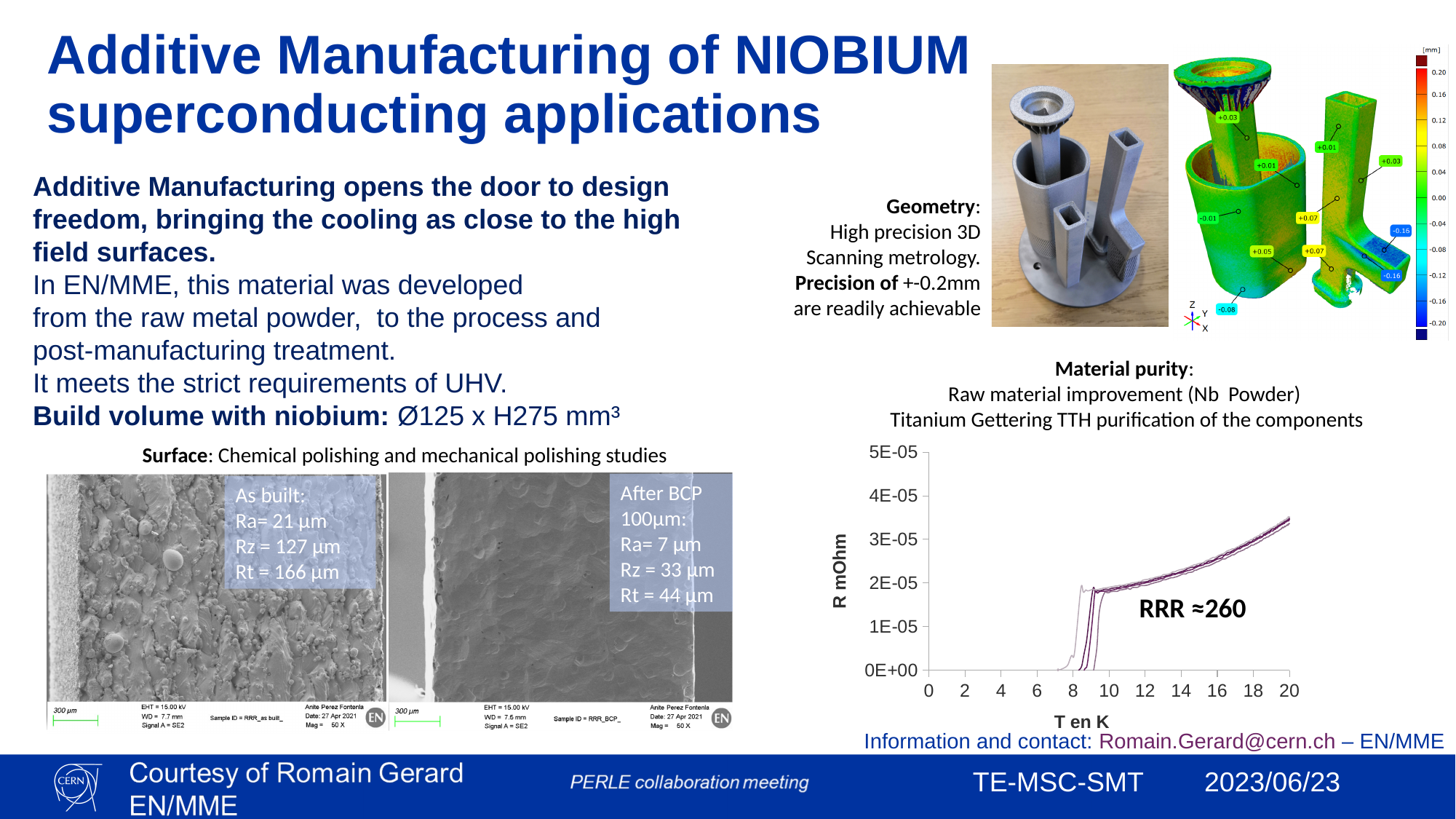
In the R mOhm versus T en K chart, do the plotted values rise or fall as temperature increases from 10 K to 20 K? rise In the R mOhm versus T en K chart, what is the highest tick value shown on the y axis? 5E-05 In the R mOhm versus T en K chart, what is the label of the x axis? T en K In the R mOhm versus T en K chart, what is the highest tick value shown on the x axis? 20 In the R mOhm versus T en K chart, which is larger: the resistance at 20 K or the resistance at 10 K? 20 K What kind of chart is shown at the bottom right of the slide, plotting R mOhm against T en K? line chart In the R mOhm versus T en K chart, is the resistance value at 12 K greater or less than 3E-05? less In the R mOhm versus T en K chart, is the resistance value at 14 K greater or less than 2E-05? greater In the R mOhm versus T en K chart, is the resistance value at 20 K greater or less than 3E-05? greater In the R mOhm versus T en K chart, what RRR value is annotated on the plot? RRR ≈260